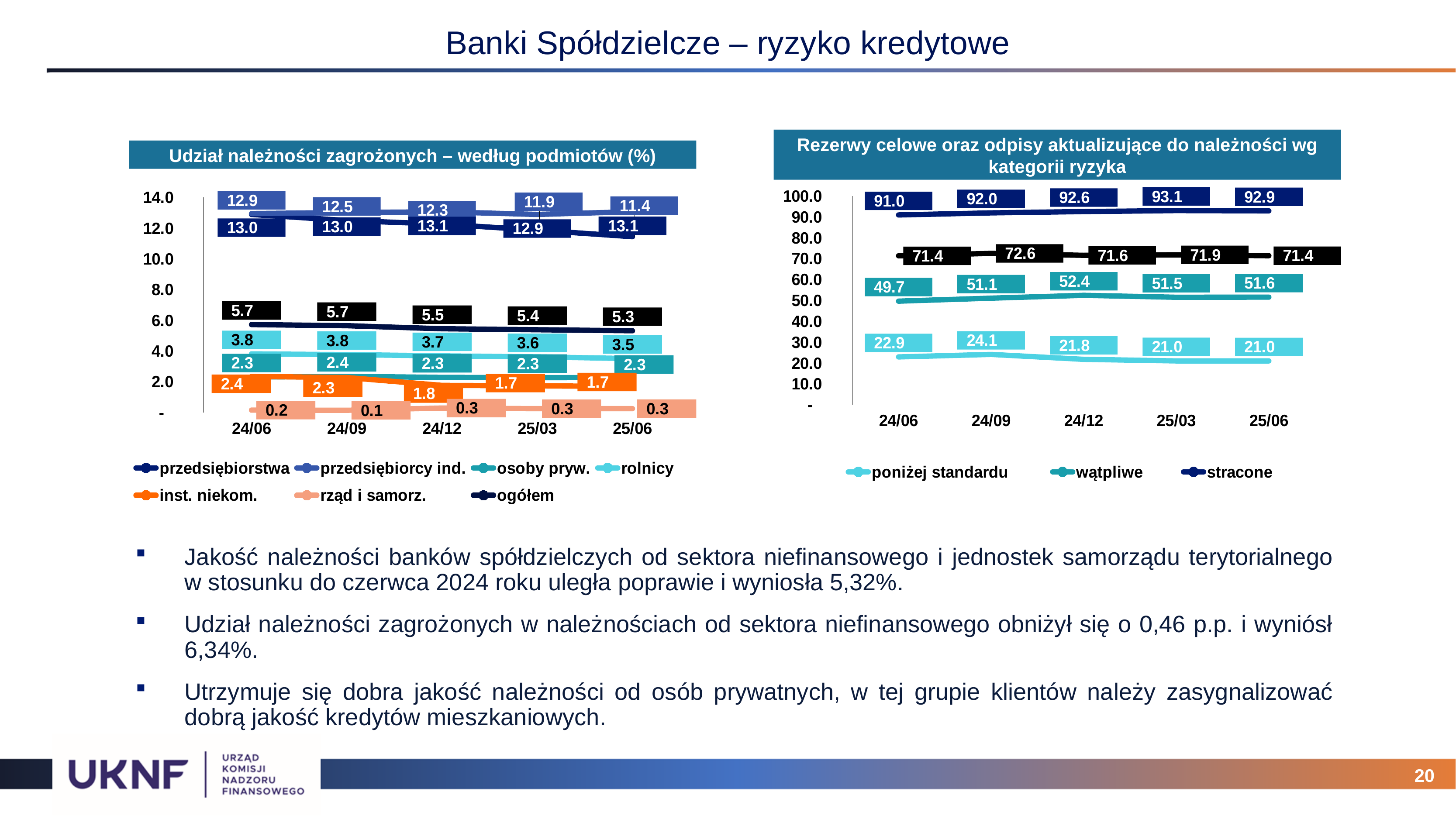
In the chart 'Udział należności zagrożonych – według podmiotów (%)', what is the difference between the 'inst. niekom.' values at 24/06 and 25/06? 0.7 What kind of chart is 'Rezerwy celowe oraz odpisy aktualizujące do należności wg kategorii ryzyka'? line chart In the chart 'Udział należności zagrożonych – według podmiotów (%)', what is the value for 'rząd i samorz.' at 24/09? 0.1 In the chart 'Rezerwy celowe oraz odpisy aktualizujące do należności wg kategorii ryzyka', what is the value for 'stracone' at 25/03? 93.1 In the chart 'Udział należności zagrożonych – według podmiotów (%)', what is the value for 'przedsiębiorcy ind.' at 24/06? 12.9 In the chart 'Udział należności zagrożonych – według podmiotów (%)', does the 'przedsiębiorcy ind.' series rise or fall from 24/06 to 25/06? fall In the chart 'Udział należności zagrożonych – według podmiotów (%)', what is the value for 'ogółem' at 25/06? 5.3 In the chart 'Rezerwy celowe oraz odpisy aktualizujące do należności wg kategorii ryzyka', at which period is 'poniżej standardu' highest? 24/09 In the chart 'Rezerwy celowe oraz odpisy aktualizujące do należności wg kategorii ryzyka', what is the value for 'wątpliwe' at 24/12? 52.4 In the chart 'Udział należności zagrożonych – według podmiotów (%)', how many series does the legend list? 7 In the chart 'Rezerwy celowe oraz odpisy aktualizujące do należności wg kategorii ryzyka', how many periods are shown on the x axis? 5 In the chart 'Udział należności zagrożonych – według podmiotów (%)', which series has the highest value at 25/06? przedsiębiorstwa